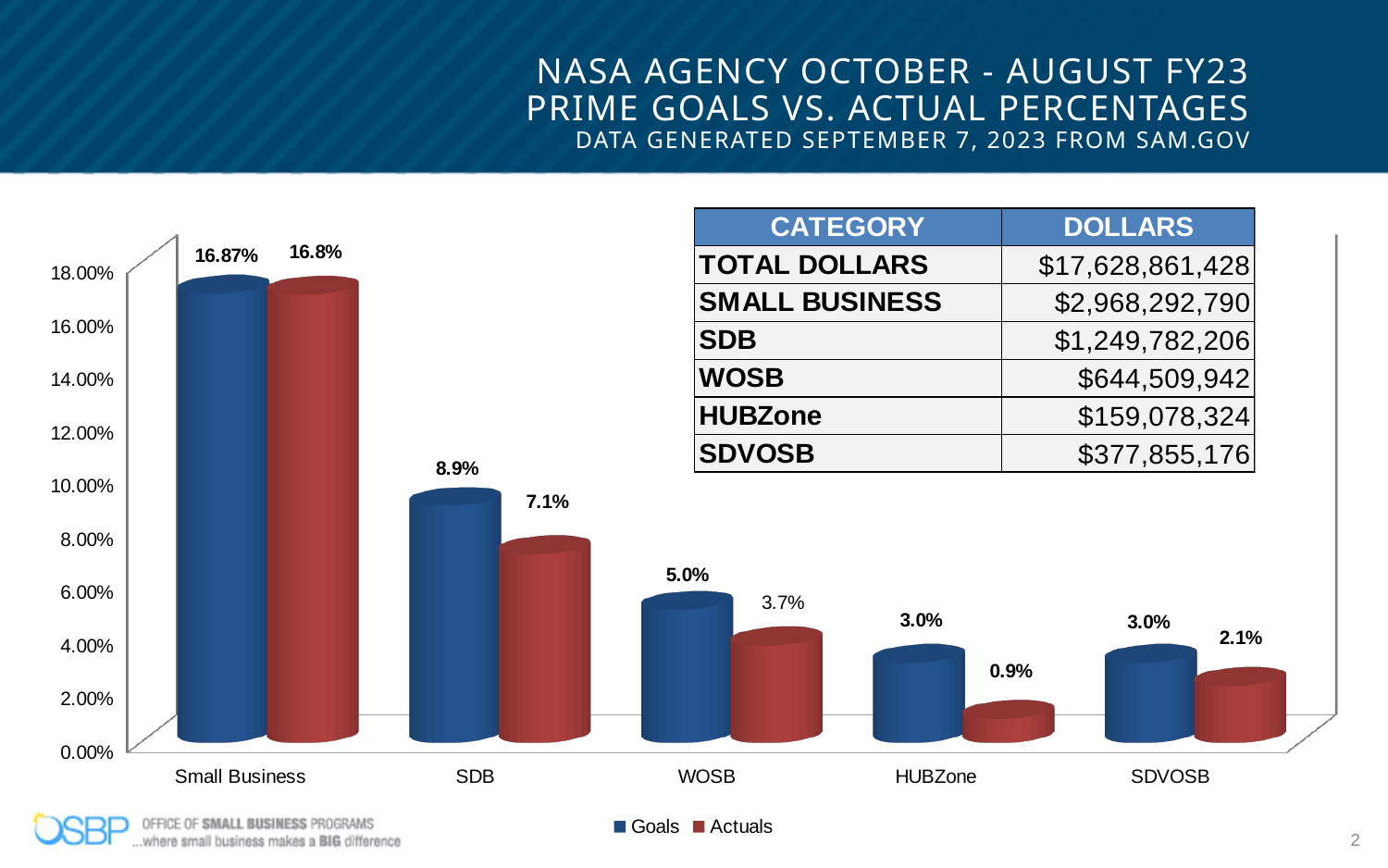
What is the Actuals value for SDB? 7.1% What is the Goals value for Small Business? 16.87% How many series does the legend list? 2 What kind of chart is shown on the slide? Bar chart How many categories are shown on the x axis? 5 Which category has the lowest Actuals value? HUBZone What is the Goals value for WOSB? 5.0% Which category has the highest Actuals value? Small Business Which is larger, the Actuals value for WOSB or the Actuals value for SDVOSB? WOSB Which colour represents the Actuals series in the chart? Red What is the Actuals value for HUBZone? 0.9% What is the difference between the Goals and Actuals values for SDB? 1.8%